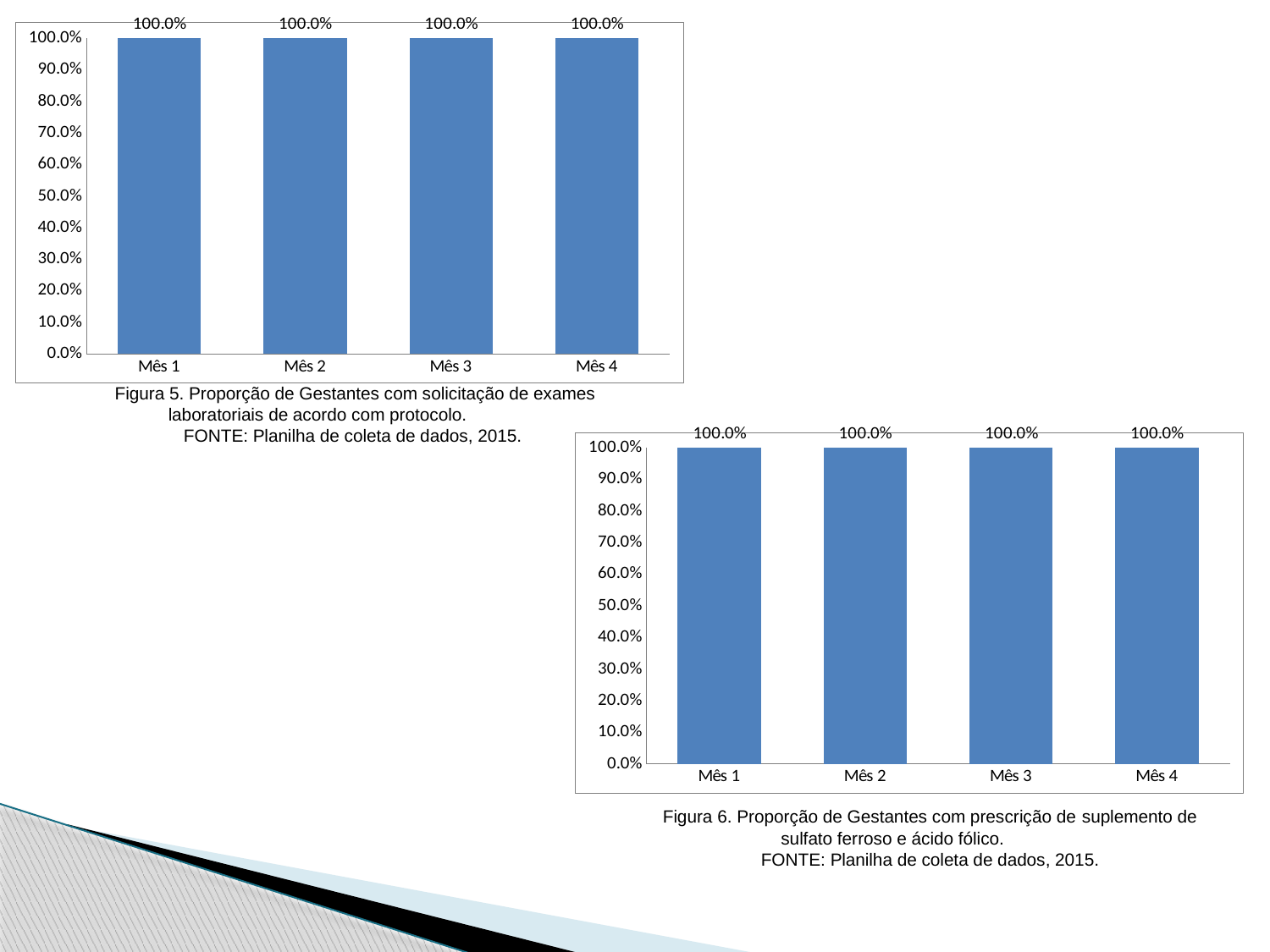
In the bottom-right chart (Figura 6), what is the value for Mês 3? 100.0% In the top-left chart (Figura 5), is the value for Mês 2 greater or less than 50.0%? greater In the top-left chart (Figura 5), what is the value for Mês 1? 100.0% In the top-left chart (Figura 5), what is the value for Mês 4? 100.0% In the top-left chart (Figura 5), what is the difference between the values for Mês 1 and Mês 4? 0.0% What is the caption of the bottom-right chart? Figura 6. Proporção de Gestantes com prescrição de suplemento de sulfato ferroso e ácido fólico. What kind of chart is the top-left chart (Figura 5)? Bar chart How many bars are plotted in the bottom-right chart (Figura 6)? 4 In the bottom-right chart (Figura 6), what is the value for Mês 2? 100.0% How many categories are shown on the x axis of the top-left chart (Figura 5)? 4 In the bottom-right chart (Figura 6), do the values rise, fall, or stay the same from Mês 1 to Mês 4? Stay the same What kind of chart is the bottom-right chart (Figura 6)? Bar chart